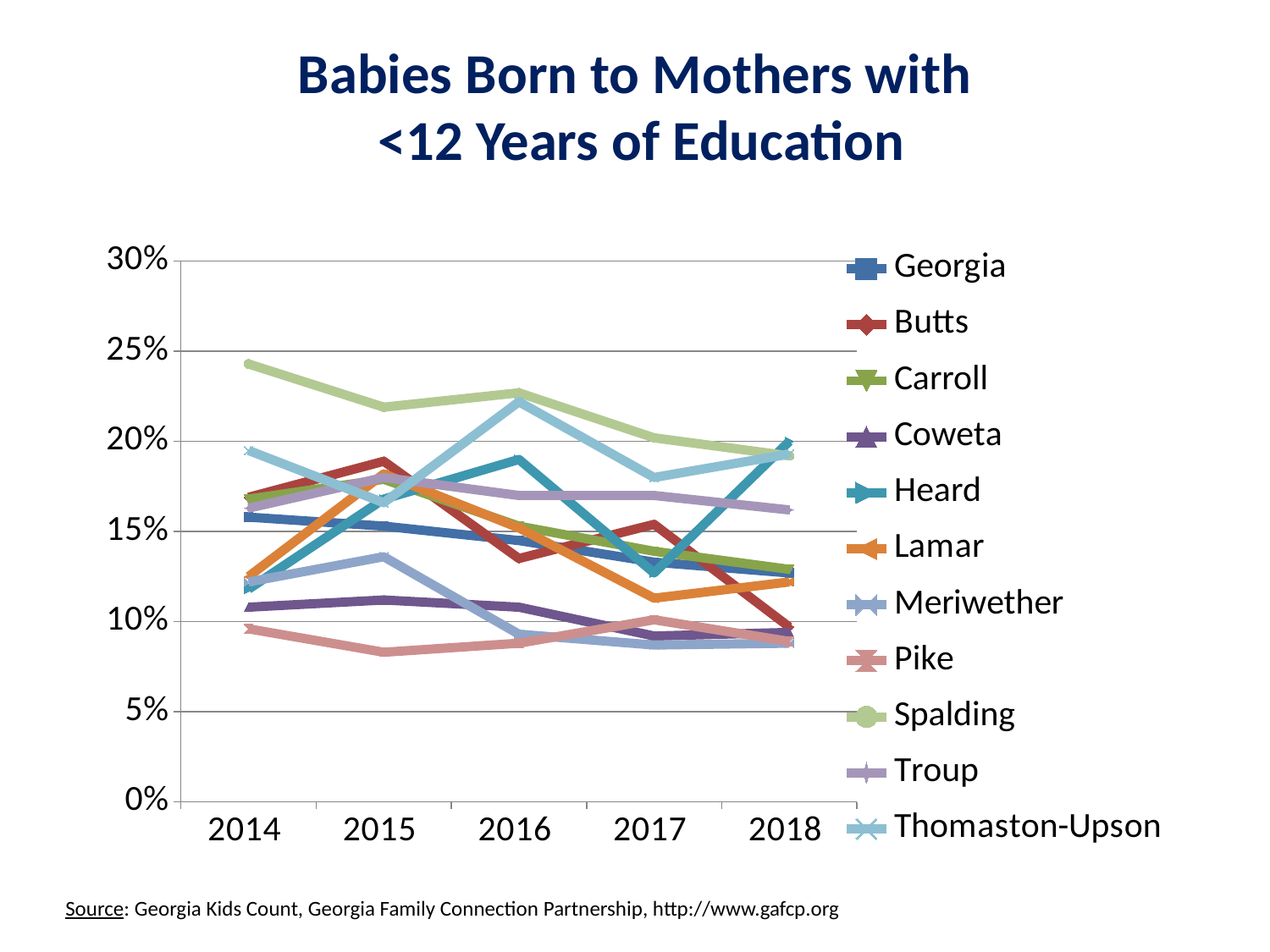
Which series has the highest value in 2014? Spalding How many series does the legend list? 11 Is the value for Butts in 2015 greater or less than 15%? greater Which series has the lowest value in 2015? Pike How many years are shown on the x axis? 5 Is the value for Spalding in 2014 greater or less than 20%? greater Does the Georgia line rise or fall from 2014 to 2018? fall Which series has the highest value in 2015? Spalding Is the value for Pike in 2015 greater or less than 10%? less What kind of chart is shown on the slide? line chart In 2016, which is larger: the value for Spalding or the value for Georgia? Spalding Which series has the lowest value in 2014? Pike